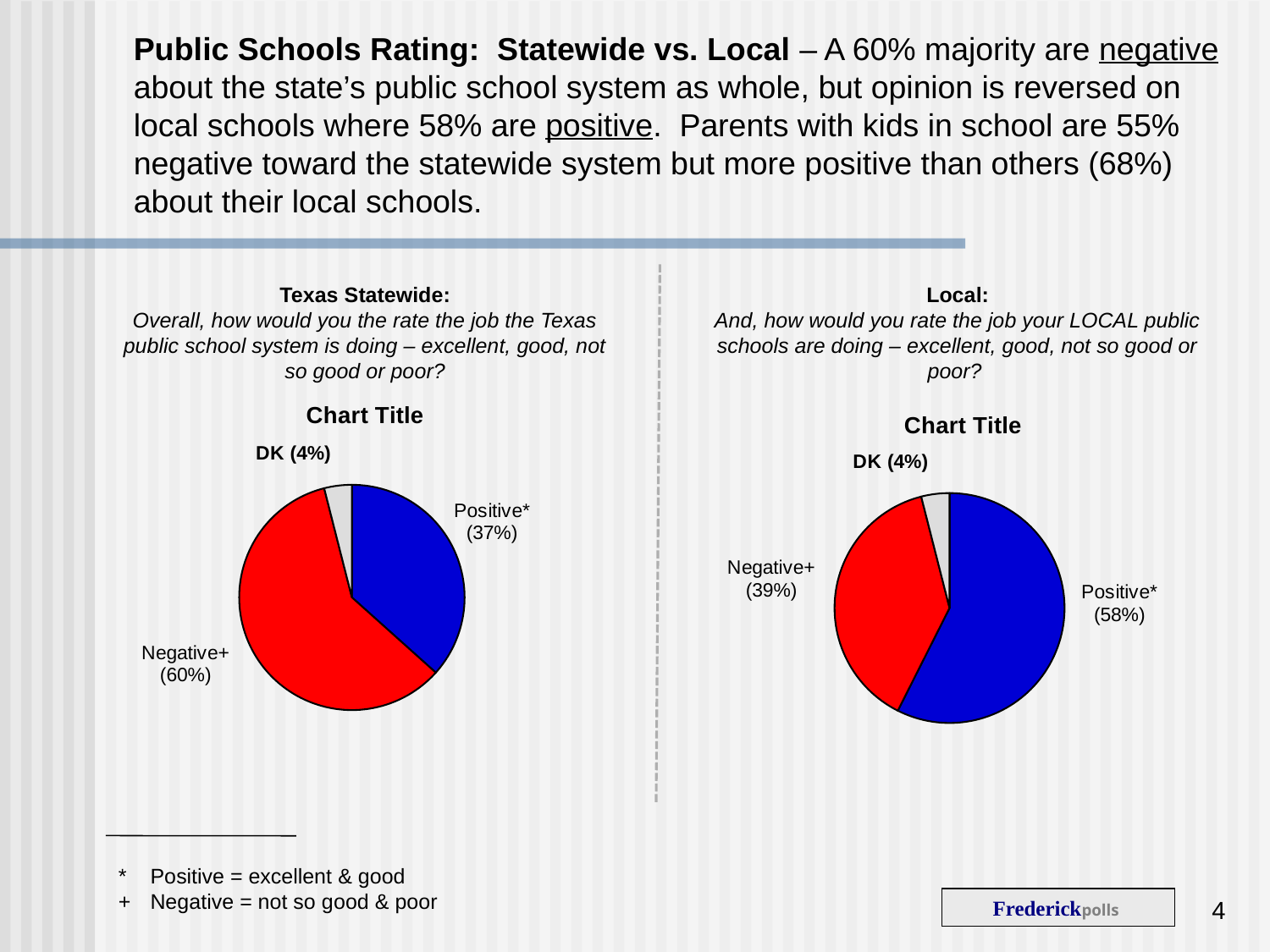
In the Local pie chart on the right, what share is DK? 4% In the Texas Statewide pie chart on the left, which slice is the largest? Negative+ In the Local pie chart on the right, what colour is the Positive* slice? Blue In the Texas Statewide pie chart on the left, what share is Negative+? 60% In the Texas Statewide pie chart on the left, what is the difference between the Negative+ and Positive* shares? 23% In the Local pie chart on the right, which slice is the smallest? DK In the Local pie chart on the right, what share is Positive*? 58% How many slices does the Texas Statewide pie chart on the left have? 3 In the Texas Statewide pie chart on the left, what share is Positive*? 37% In the Local pie chart on the right, what share is Negative+? 39% In the Local pie chart on the right, which is larger, Positive* or Negative+? Positive* What type of chart is used for the Local ratings on the right? Pie chart